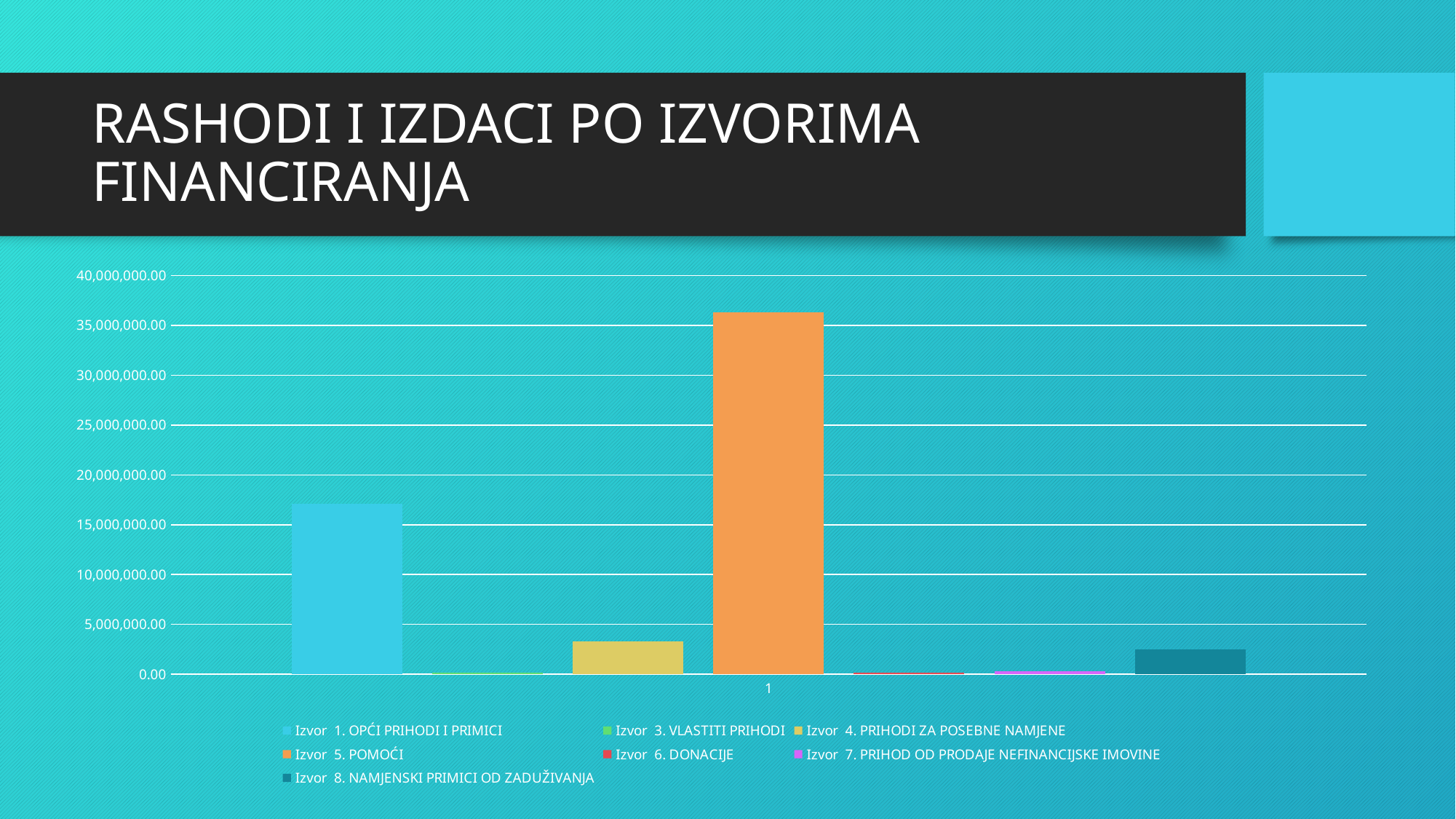
Is the value for Izvor 1. OPĆI PRIHODI I PRIMICI greater or less than 15,000,000.00? greater Is the value for Izvor 8. NAMJENSKI PRIMICI OD ZADUŽIVANJA greater or less than 5,000,000.00? less What kind of chart is shown on the slide? bar chart Is the value for Izvor 1. OPĆI PRIHODI I PRIMICI greater or less than 20,000,000.00? less How many categories are shown on the x axis? 1 What is the title of the slide containing the chart? RASHODI I IZDACI PO IZVORIMA FINANCIRANJA Which is larger, the value for Izvor 4. PRIHODI ZA POSEBNE NAMJENE or the value for Izvor 8. NAMJENSKI PRIMICI OD ZADUŽIVANJA? Izvor 4. PRIHODI ZA POSEBNE NAMJENE Which is larger, the value for Izvor 1. OPĆI PRIHODI I PRIMICI or the value for Izvor 5. POMOĆI? Izvor 5. POMOĆI How many series does the legend list? 7 Which series has the highest bar? Izvor 5. POMOĆI